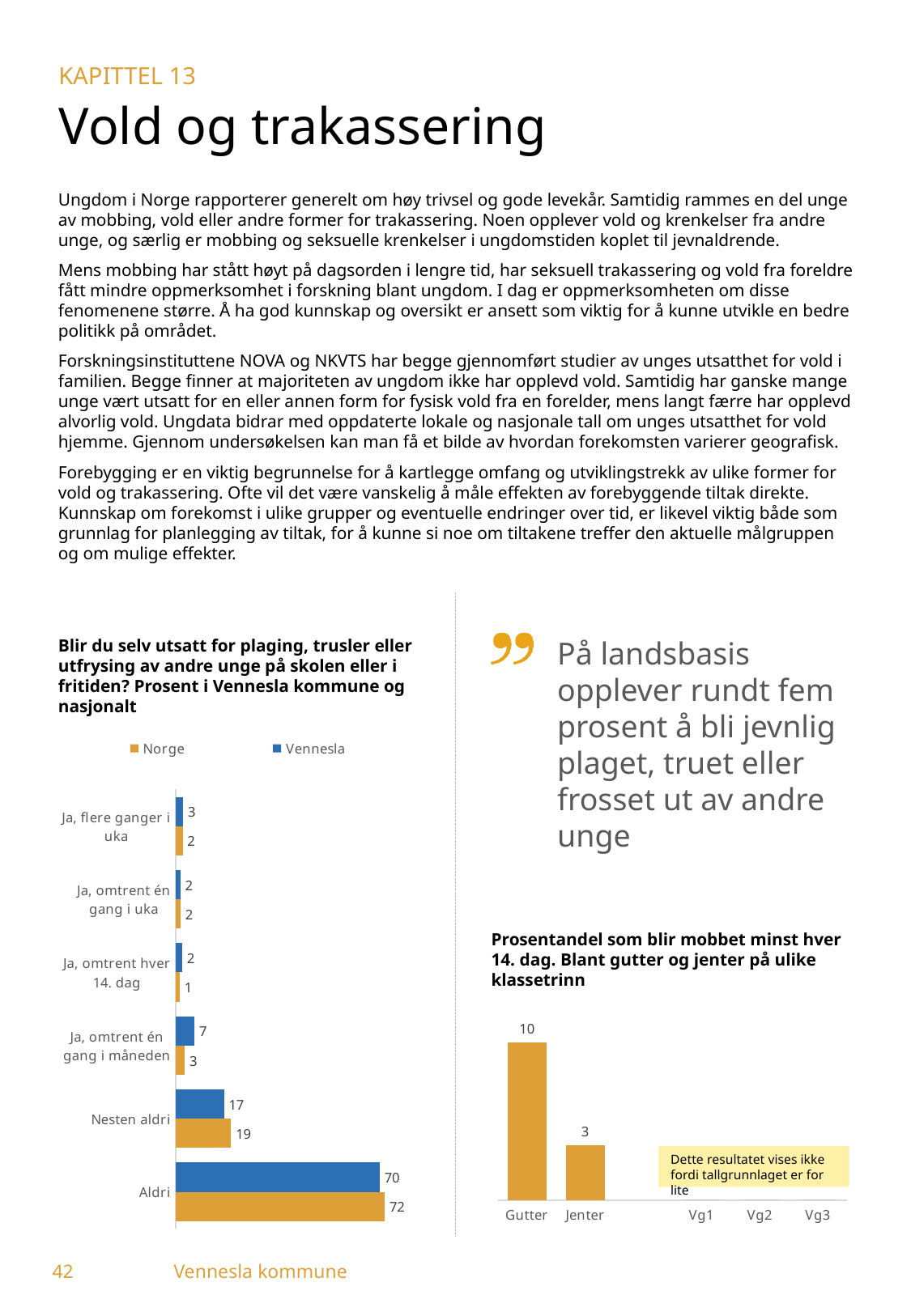
In the chart 'Blir du selv utsatt for plaging, trusler eller utfrysing av andre unge på skolen eller i fritiden?', what is the value for Vennesla for 'Aldri'? 70 In the chart 'Blir du selv utsatt for plaging, trusler eller utfrysing av andre unge på skolen eller i fritiden?', what is the difference between Norge and Vennesla for 'Aldri'? 2 In the chart 'Blir du selv utsatt for plaging, trusler eller utfrysing av andre unge på skolen eller i fritiden?', how many response categories are shown? 6 What kind of chart is 'Blir du selv utsatt for plaging, trusler eller utfrysing av andre unge på skolen eller i fritiden?'? Bar chart In the chart 'Blir du selv utsatt for plaging, trusler eller utfrysing av andre unge på skolen eller i fritiden?', which category has the highest value for Norge? Aldri In the chart 'Prosentandel som blir mobbet minst hver 14. dag', what is the value for Gutter? 10 In the chart 'Prosentandel som blir mobbet minst hver 14. dag', what is the difference between Gutter and Jenter? 7 In the chart 'Blir du selv utsatt for plaging, trusler eller utfrysing av andre unge på skolen eller i fritiden?', how many series does the legend list? 2 In the chart 'Blir du selv utsatt for plaging, trusler eller utfrysing av andre unge på skolen eller i fritiden?', what is the value for Vennesla for 'Ja, omtrent én gang i måneden'? 7 In the chart 'Blir du selv utsatt for plaging, trusler eller utfrysing av andre unge på skolen eller i fritiden?', what is the value for Norge for 'Nesten aldri'? 19 In the chart 'Prosentandel som blir mobbet minst hver 14. dag', which colour are the bars? Orange In the chart 'Blir du selv utsatt for plaging, trusler eller utfrysing av andre unge på skolen eller i fritiden?', which is larger for 'Ja, omtrent én gang i måneden': Norge or Vennesla? Vennesla